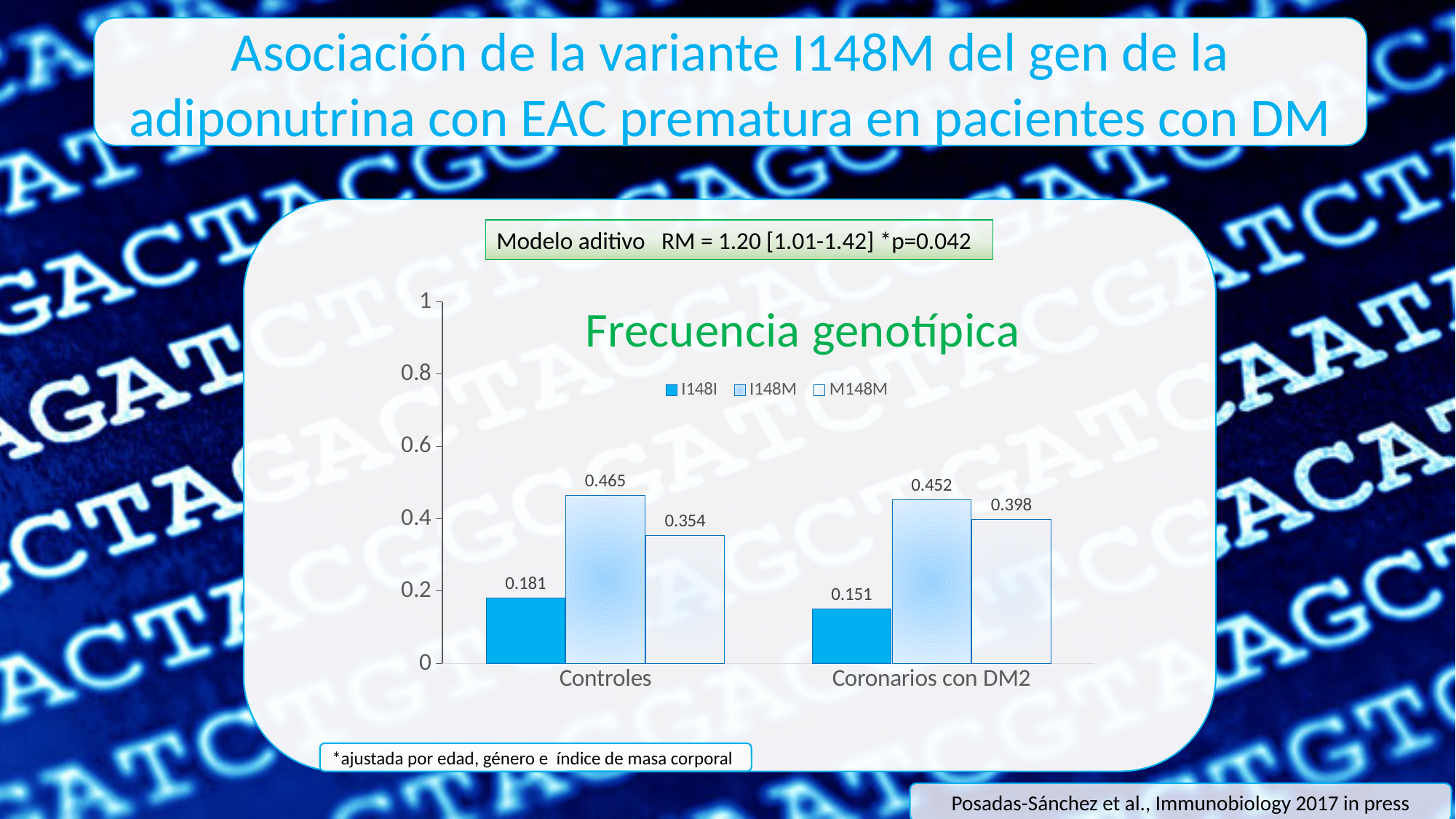
Which genotype has the highest frequency in the Coronarios con DM2 group? I148M What is the value for I148M in the Coronarios con DM2 group? 0.452 What kind of chart is shown? bar chart How many series does the legend list? 3 Is the value for I148M in the Controles group greater or less than 0.4? greater What is the title of the chart? Frecuencia genotípica Which is larger, the I148I value for Controles or for Coronarios con DM2? Controles What is the value for I148I in the Controles group? 0.181 What is the value for M148M in the Controles group? 0.354 How many groups are shown on the x axis? 2 What is the difference between the M148M values for Coronarios con DM2 and Controles? 0.044 Which genotype has the lowest frequency in the Controles group? I148I